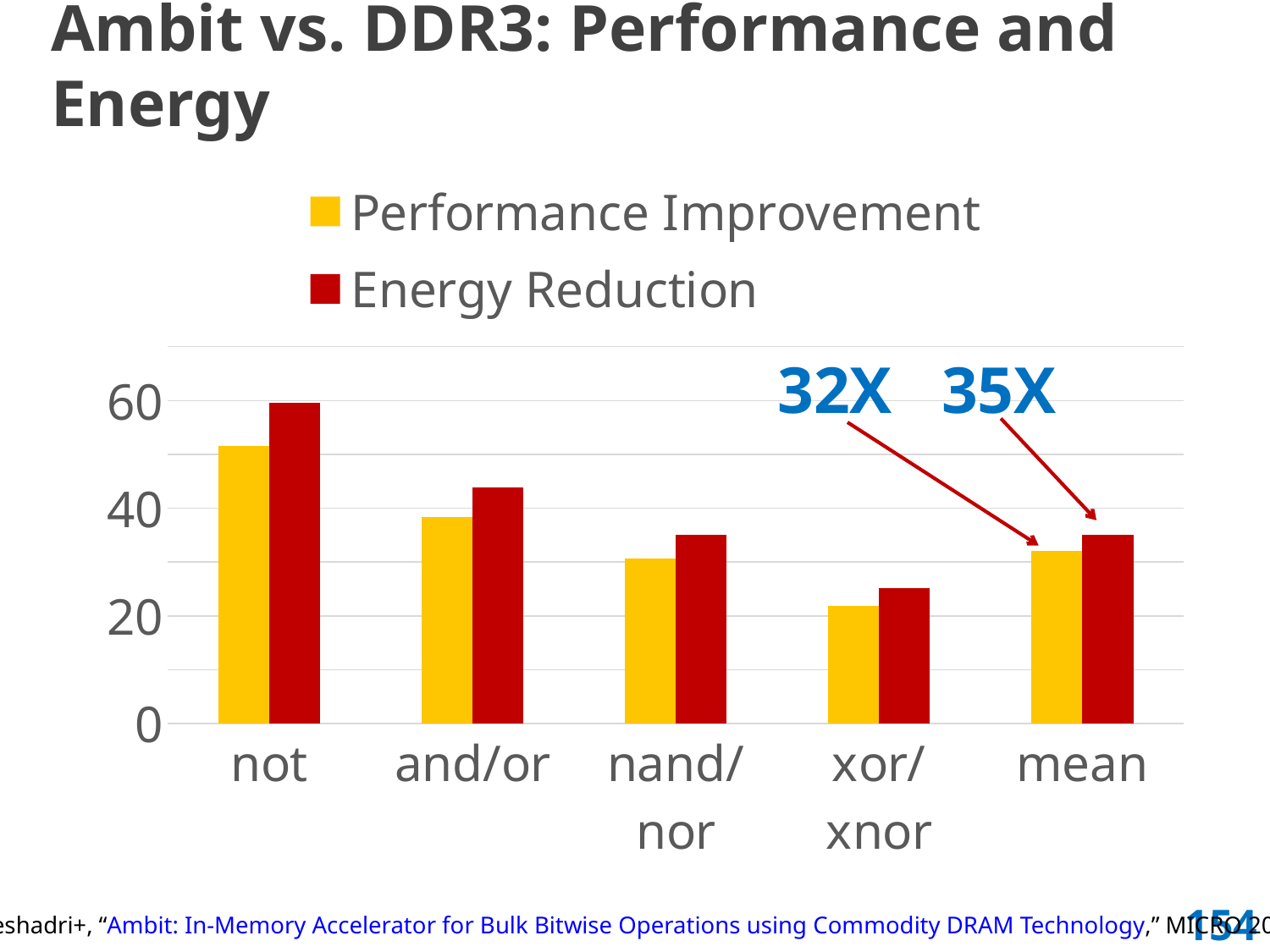
What is the Energy Reduction value for the mean category? 35X Which category has the lowest Performance Improvement? xor/xnor Is the Energy Reduction value for not greater or less than 40? greater How many series does the legend list? 2 What is the difference between the Energy Reduction and Performance Improvement values for the mean category? 3X What is the Performance Improvement value for the mean category? 32X Which colour represents Energy Reduction in the legend? red Which category has the highest Energy Reduction? not What kind of chart is shown on the slide? bar chart Which has a larger Performance Improvement, not or and/or? not How many categories are shown on the x axis? 5 Is the Energy Reduction value for xor/xnor greater or less than 40? less